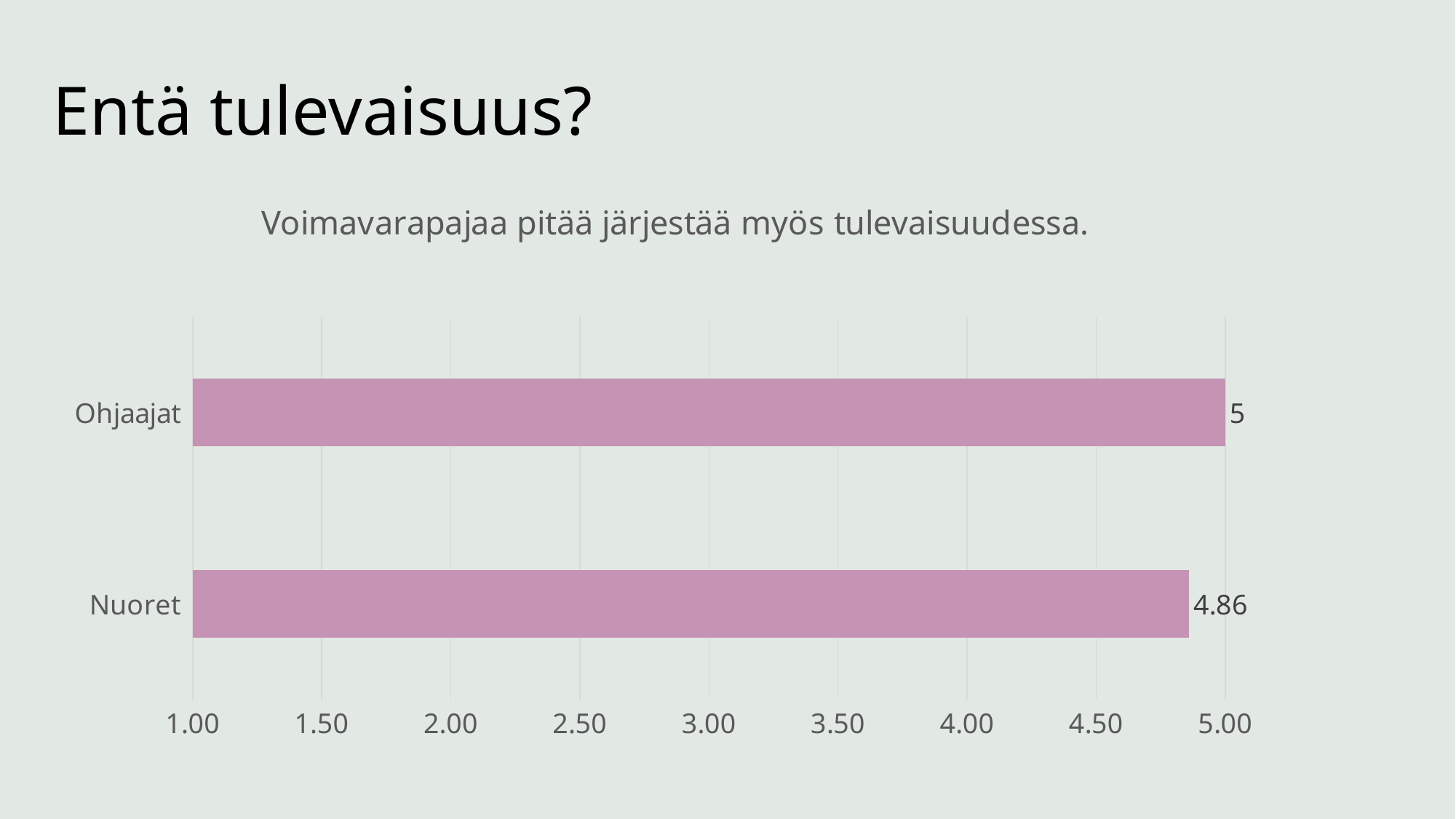
How many categories are shown in the chart? 2 What is the difference between the values for Ohjaajat and Nuoret? 0.14 Which is larger, the value for Ohjaajat or the value for Nuoret? Ohjaajat What kind of chart is shown on the slide? bar chart Which category has the highest value? Ohjaajat What is the title of the chart? Voimavarapajaa pitää järjestää myös tulevaisuudessa. Which category has the lowest value? Nuoret What is the value for Nuoret? 4.86 What is the value for Ohjaajat? 5 What is the highest value shown on the x axis? 5.00 Is the value for Nuoret greater or less than 4.50? greater